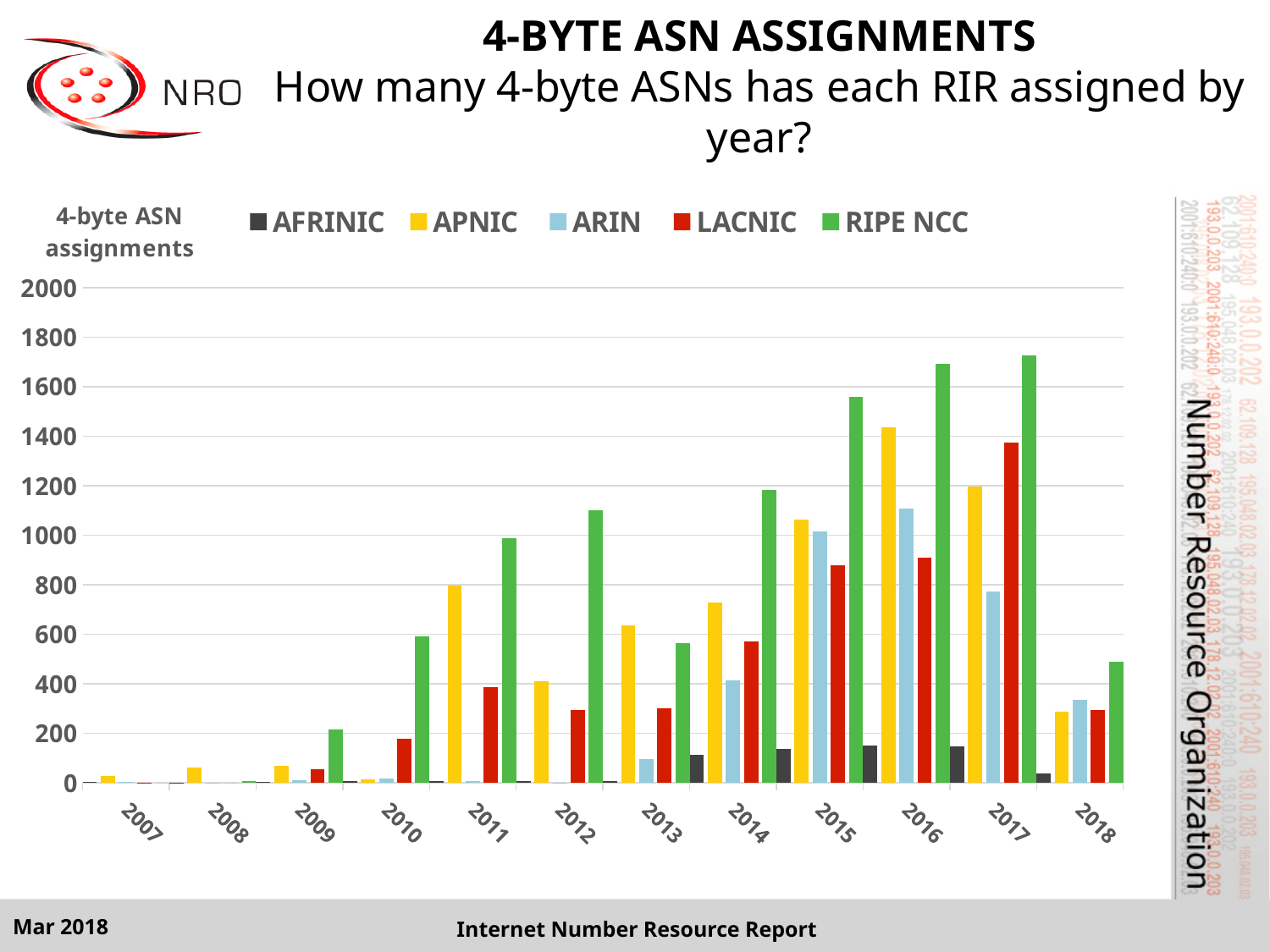
Which RIR has the lowest number of 4-byte ASN assignments in 2017? AFRINIC Which RIR has the highest number of 4-byte ASN assignments in 2016? RIPE NCC Is the value for ARIN in 2016 greater or less than 1000? greater What kind of chart is shown on the slide? bar chart How many series does the legend list? 5 In 2014, which is larger: the value for APNIC or the value for LACNIC? APNIC Is the value for APNIC in 2011 greater or less than 1000? less Do the RIPE NCC values generally rise or fall from 2009 to 2017? rise Is the value for LACNIC in 2016 greater or less than 1000? less In 2017, which is larger: the value for LACNIC or the value for APNIC? LACNIC How many years are shown on the x axis? 12